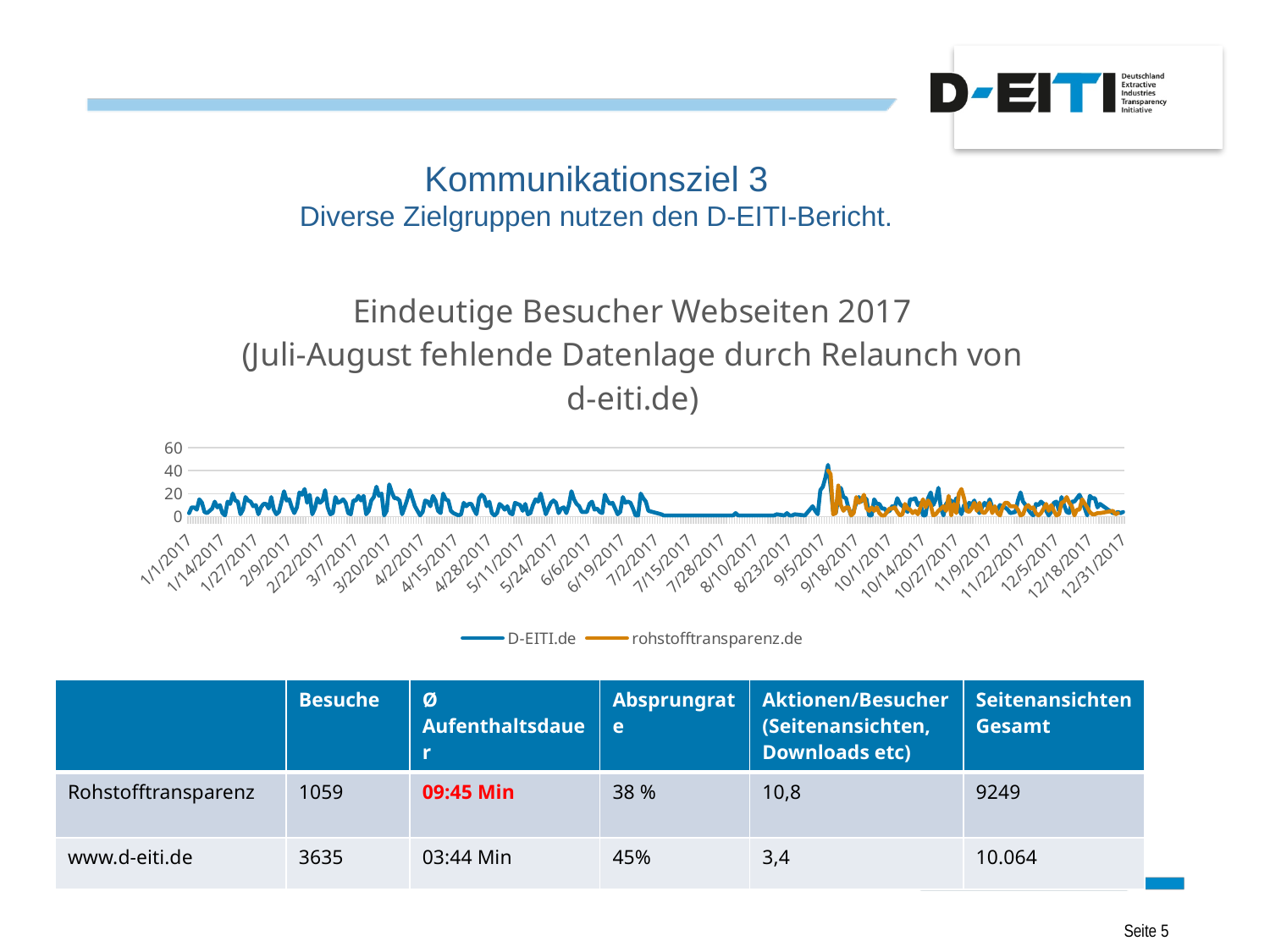
What are the two series named in the chart legend? D-EITI.de and rohstofftransparenz.de What kind of chart is shown on the slide? line chart What is the title of the chart? Eindeutige Besucher Webseiten 2017 (Juli-August fehlende Datenlage durch Relaunch von d-eiti.de) Does the D-EITI.de line rise or fall from late June into July 2017? fall Does the D-EITI.de line rise or fall from late August to early September 2017? rise Is the highest value reached by the D-EITI.de line greater or less than 60? less Which series reaches the higher peak value in the chart, D-EITI.de or rohstofftransparenz.de? D-EITI.de Are the values for rohstofftransparenz.de in December 2017 greater or less than 40? less Is the value for D-EITI.de on 1/1/2017 greater or less than 40? less How many series does the chart legend list? 2